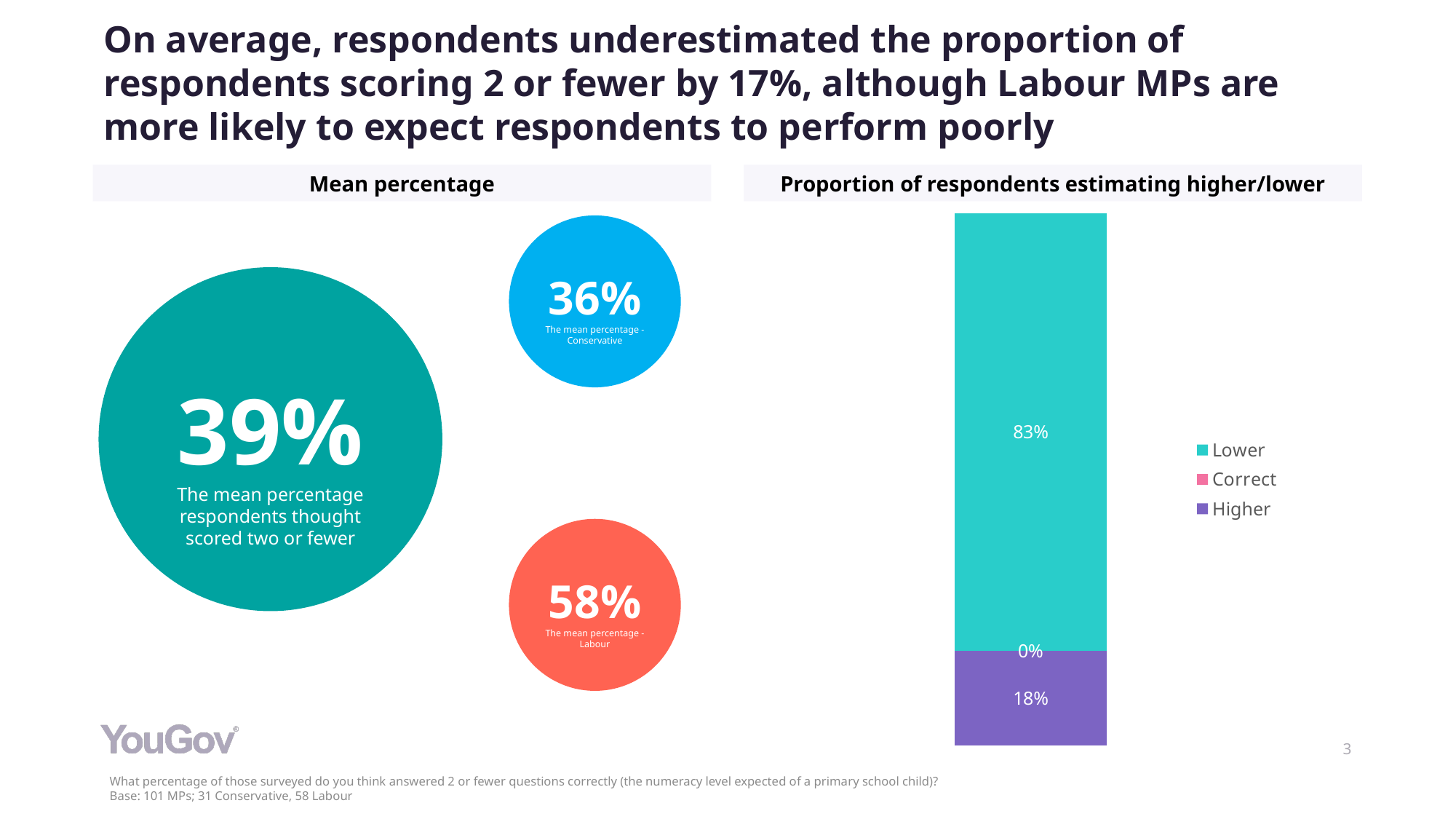
In the 'Proportion of respondents estimating higher/lower' chart, which is larger, Lower or Higher? Lower In the 'Mean percentage' section, what is the difference between the Labour and Conservative mean percentages? 22% In the 'Mean percentage' section, what is the mean percentage for Labour? 58% In the 'Proportion of respondents estimating higher/lower' chart, what is the difference between the Lower and Higher percentages? 65% In the 'Proportion of respondents estimating higher/lower' chart, what colour is the Higher segment? Purple In the 'Proportion of respondents estimating higher/lower' chart, what percentage of respondents estimated lower? 83% In the 'Proportion of respondents estimating higher/lower' chart, what percentage of respondents estimated higher? 18% In the 'Proportion of respondents estimating higher/lower' chart, which segment is the largest? Lower In the 'Proportion of respondents estimating higher/lower' chart, which segment is the smallest? Correct What kind of chart is the 'Proportion of respondents estimating higher/lower' chart? Stacked bar chart How many series does the legend of the 'Proportion of respondents estimating higher/lower' chart list? 3 In the 'Proportion of respondents estimating higher/lower' chart, what percentage of respondents estimated correctly? 0%